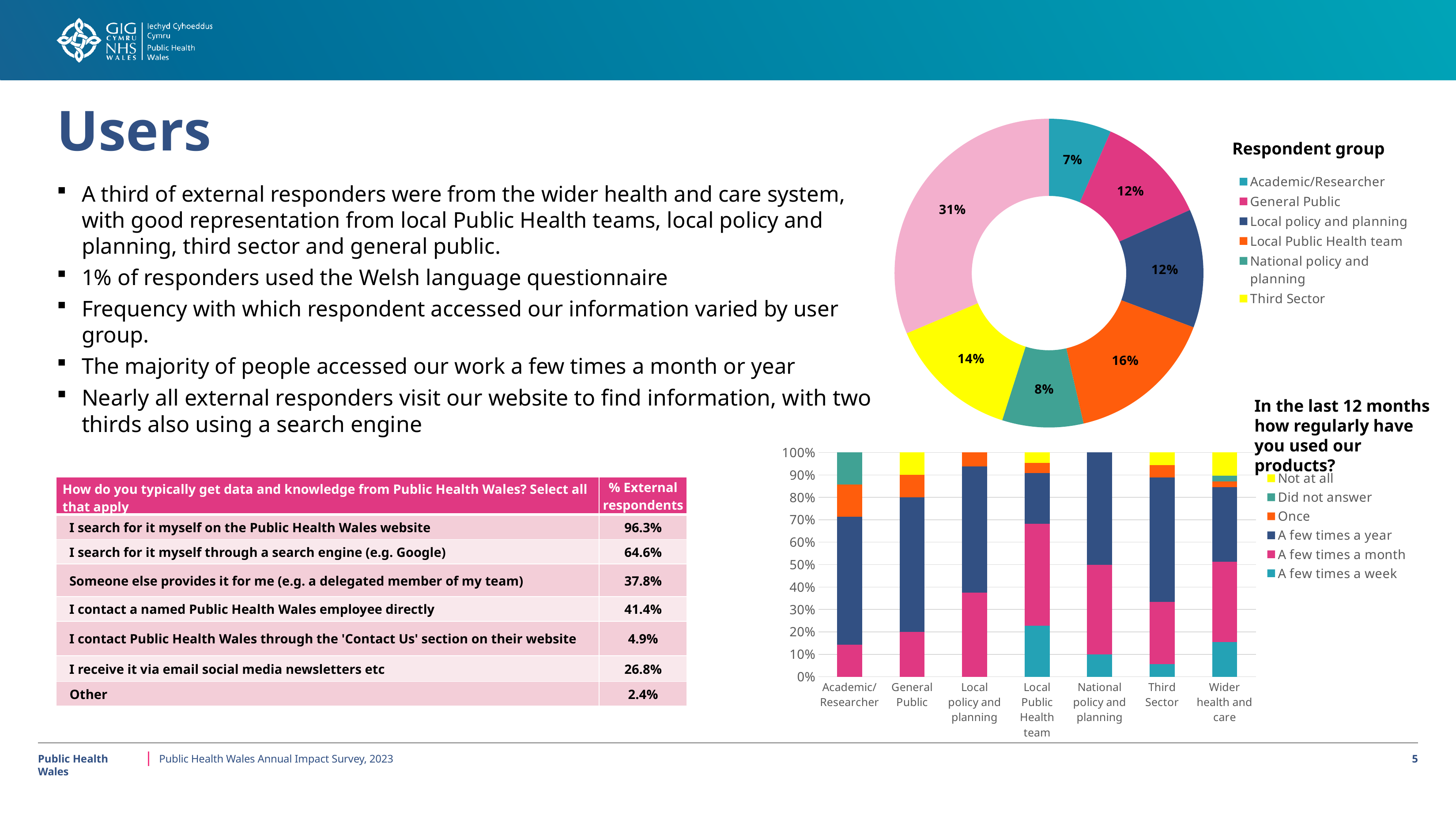
In the Respondent group donut chart, which is larger: Third Sector or National policy and planning? Third Sector In the stacked bar chart 'In the last 12 months how regularly have you used our products?', is the 'A few times a year' segment for Academic/Researcher greater or less than 50%? greater How many entries does the legend of the Respondent group donut chart list? 6 In the Respondent group donut chart, how many percentage points larger is Local Public Health team than Third Sector? 2% In the Respondent group donut chart, what percentage is shown for Third Sector? 14% In the stacked bar chart 'In the last 12 months how regularly have you used our products?', is the 'A few times a month' segment for Local policy and planning greater or less than 30%? greater In the stacked bar chart 'In the last 12 months how regularly have you used our products?', how many respondent groups are shown on the x axis? 7 In the Respondent group donut chart, which legend group has the smallest share? Academic/Researcher In the Respondent group donut chart, what percentage is shown for Academic/Researcher? 7% In the Respondent group donut chart, what percentage is shown for Local Public Health team? 16% In the Respondent group donut chart, what percentage is shown for National policy and planning? 8% In the Respondent group donut chart, what is the largest percentage label shown on any slice? 31%